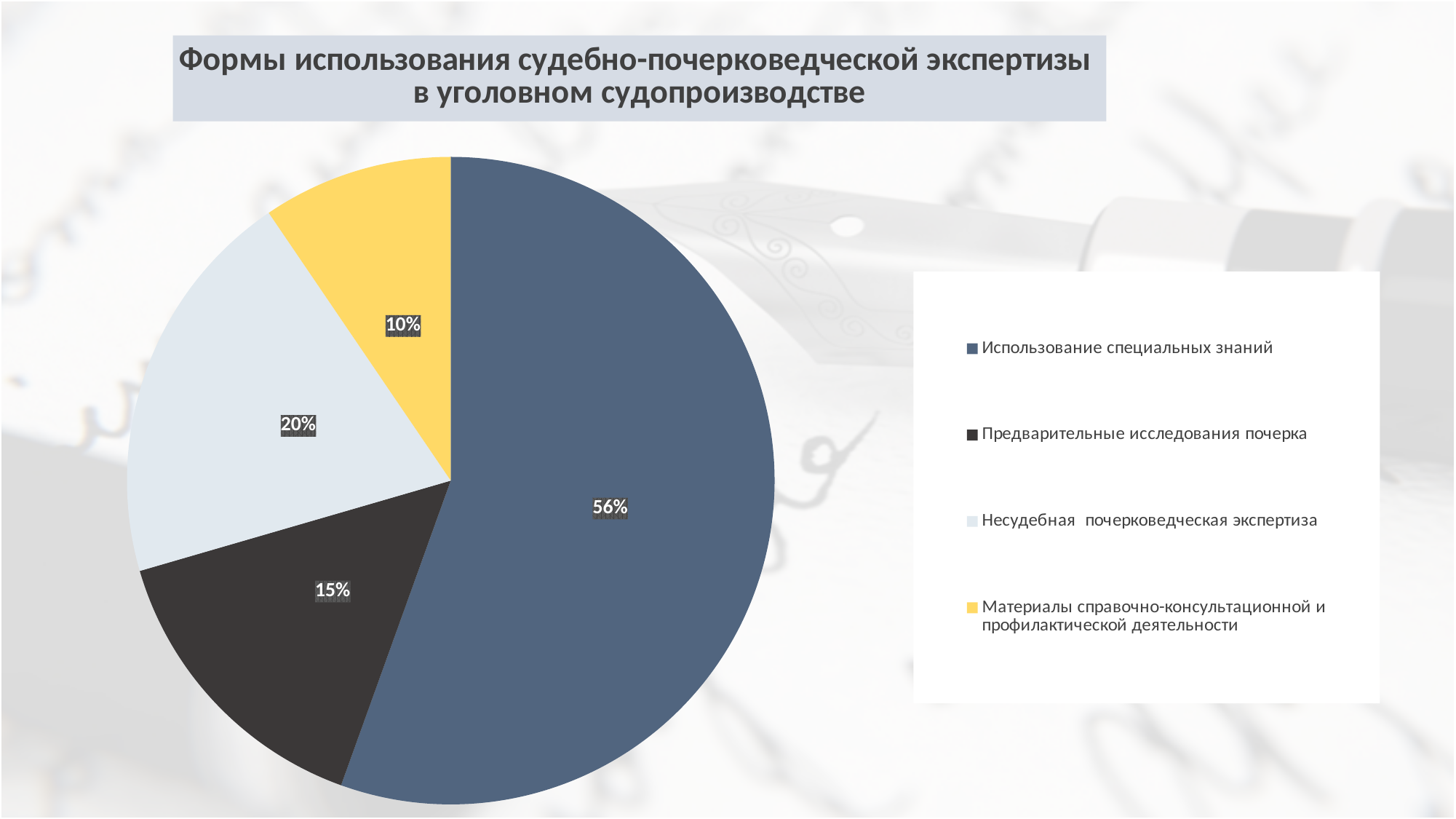
What is the difference between the shares of "Использование специальных знаний" and "Несудебная почерковедческая экспертиза"? 36% What is the title of the chart? Формы использования судебно-почерковедческой экспертизы в уголовном судопроизводстве What is the value for "Материалы справочно-консультационной и профилактической деятельности"? 10% Which category has the largest slice of the pie? Использование специальных знаний What type of chart is shown on the slide? Pie chart Which category has the smallest slice of the pie? Материалы справочно-консультационной и профилактической деятельности What is the value for "Несудебная почерковедческая экспертиза"? 20% Which is larger: "Предварительные исследования почерка" or "Несудебная почерковедческая экспертиза"? Несудебная почерковедческая экспертиза What colour is the slice for "Материалы справочно-консультационной и профилактической деятельности"? Yellow What is the value for "Предварительные исследования почерка"? 15% How many categories does the pie chart have? 4 What share of the pie does "Использование специальных знаний" have? 56%